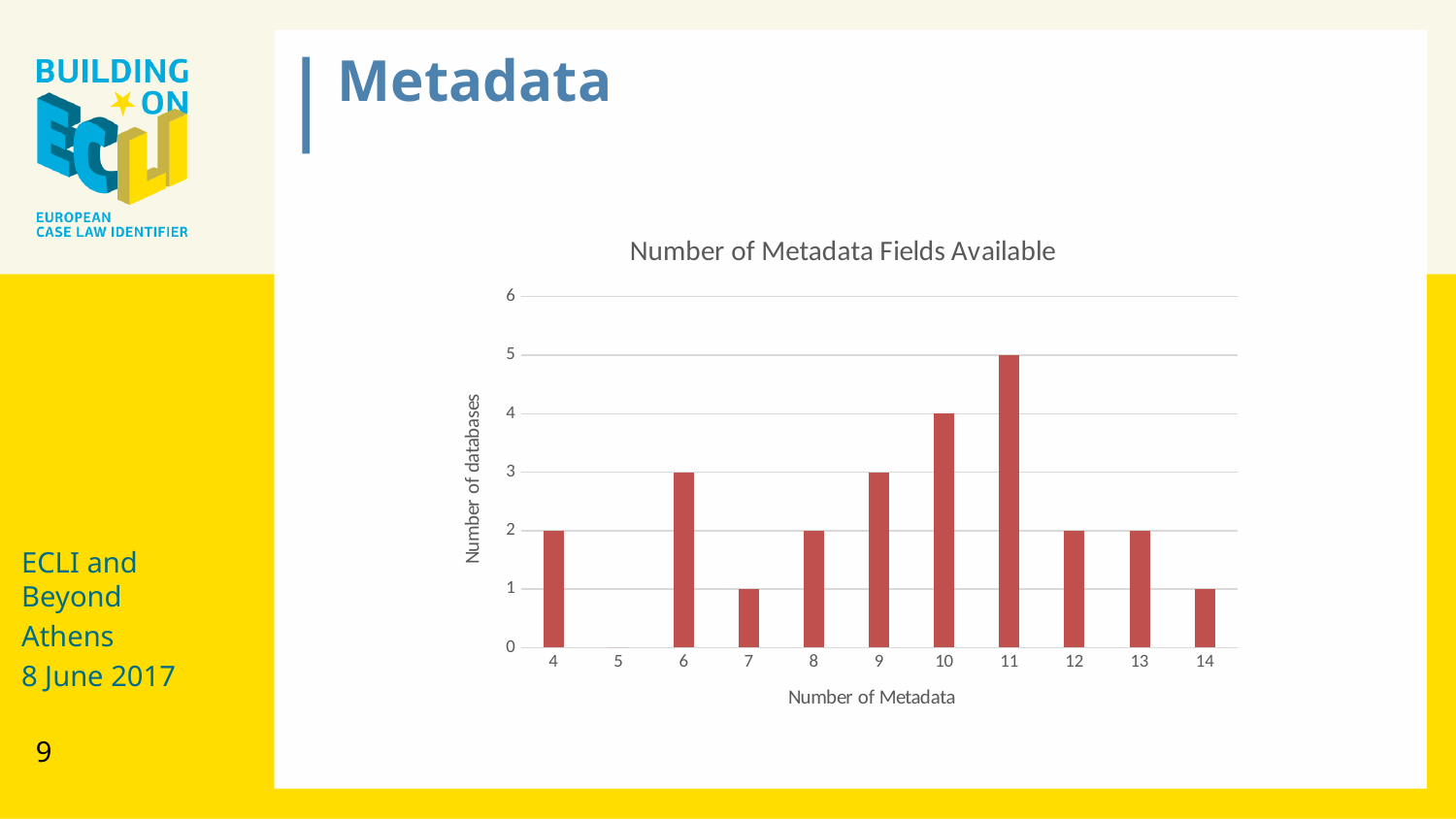
What is the difference between the number of databases with 11 metadata fields and the number with 10 metadata fields? 1 Which has more databases: 6 metadata fields or 8 metadata fields? 6 metadata fields What is the title of the chart? Number of Metadata Fields Available What type of chart is shown on the slide? bar chart How many categories are shown on the x axis? 11 Which number of metadata fields has the highest number of databases? 11 How many databases have 10 metadata fields? 4 How many databases have 11 metadata fields? 5 Which number of metadata fields has no databases at all? 5 How many databases have 7 metadata fields? 1 Is the number of databases with 11 metadata fields greater or less than 4? greater What is the label of the vertical axis? Number of databases